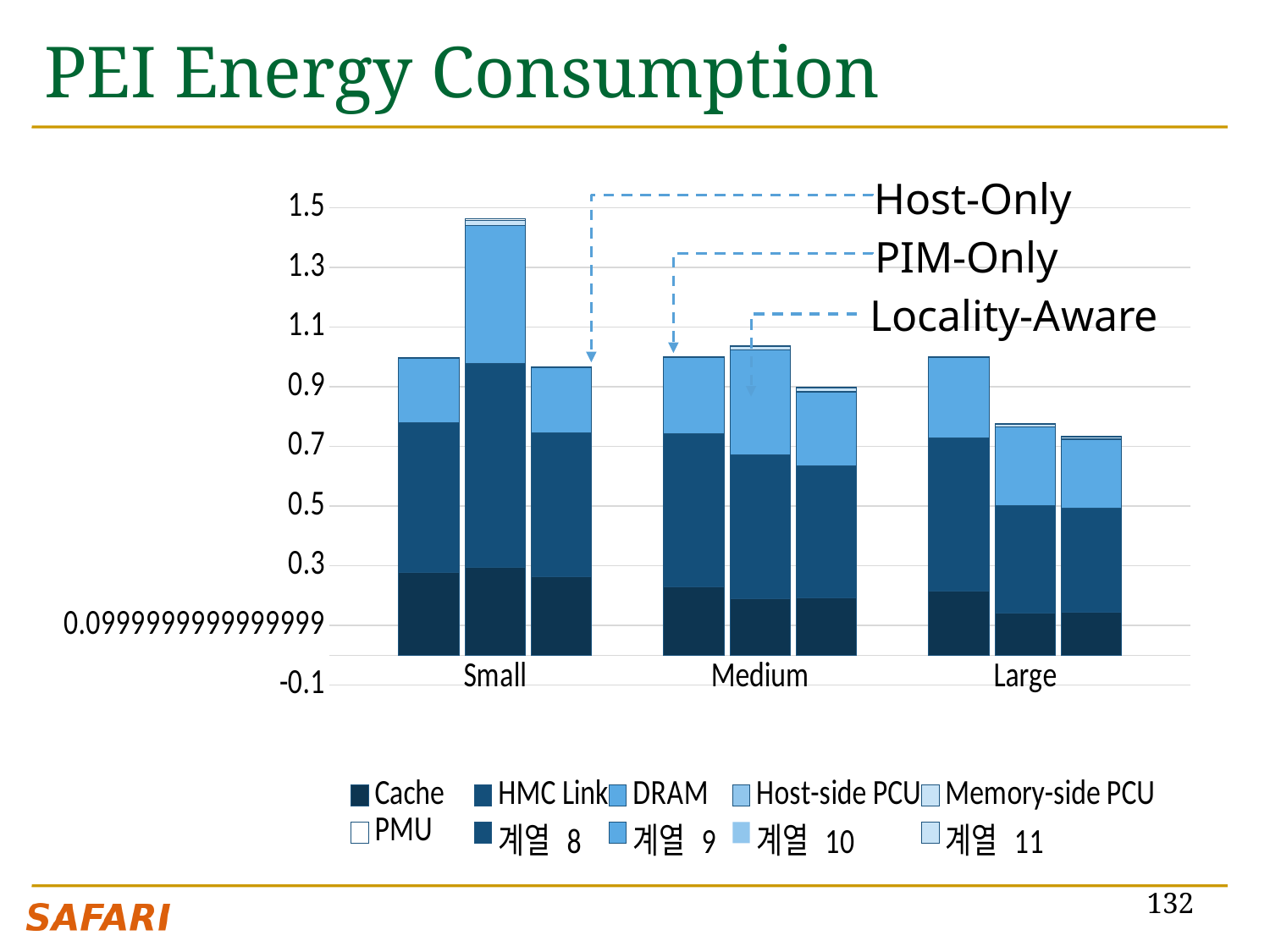
Is the PIM-Only bar for Large greater or less than 0.9? less How many categories are shown on the x axis? 3 Do the PIM-Only bars rise or fall from Small to Large? fall Which bar is the tallest in the chart? PIM-Only for Small Is the PIM-Only bar for Small greater or less than 1.3? greater What kind of chart is shown on the slide? stacked bar chart Is the Host-Only bar for Medium greater or less than 0.9? greater How many series does the legend list? 10 For Medium, which is taller: the PIM-Only bar or the Locality-Aware bar? PIM-Only What is the title of the chart? PEI Energy Consumption Which three configurations are labelled by the dashed arrows above the bars? Host-Only, PIM-Only, Locality-Aware